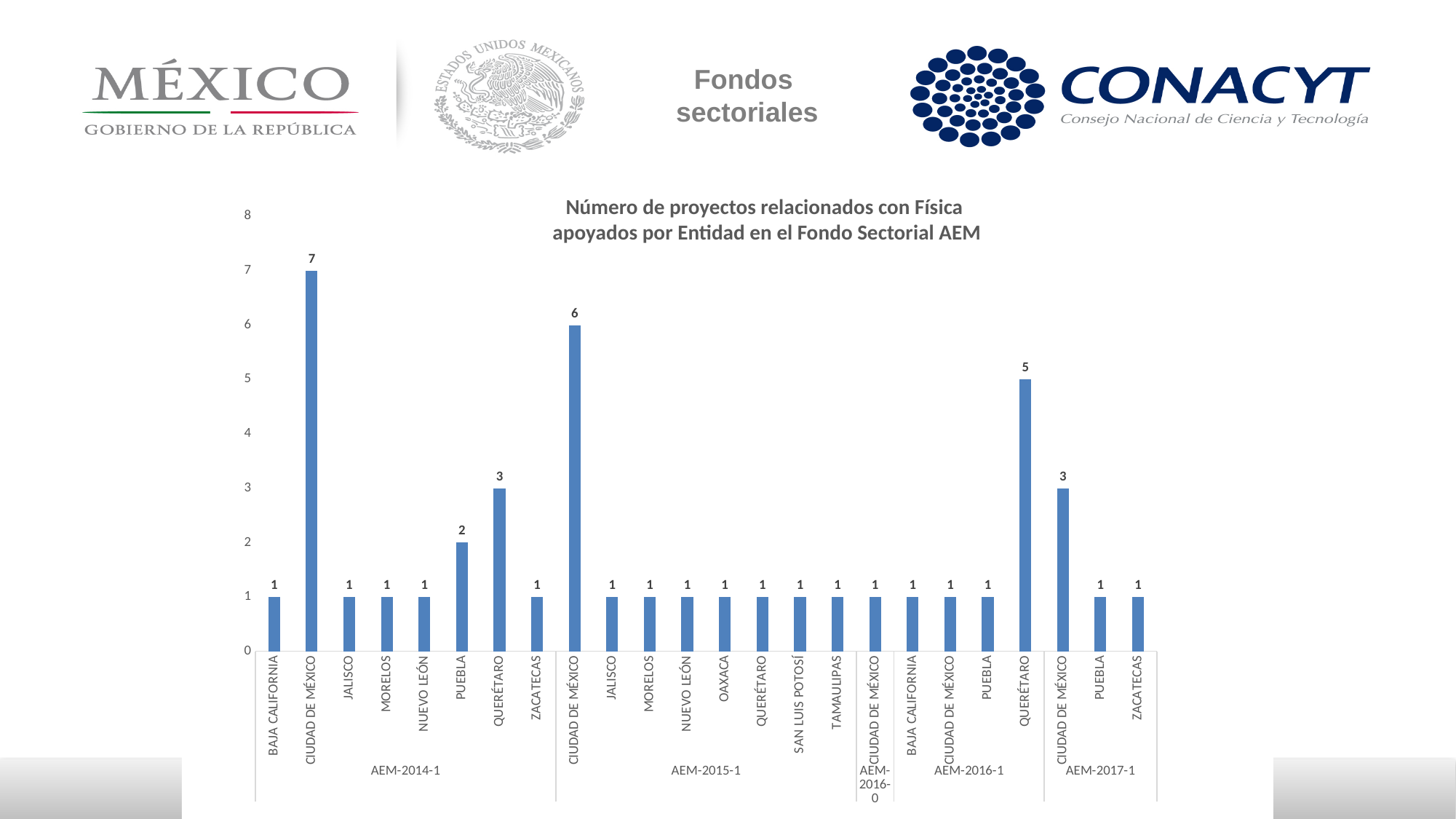
What type of chart is shown on the slide? Bar chart What is the value for Querétaro in the AEM-2016-1 group? 5 Which bar has the highest value in the whole chart? Ciudad de México (AEM-2014-1) How many projects does Ciudad de México have in the AEM-2014-1 group? 7 Which entity has the highest value in the AEM-2015-1 group? Ciudad de México What is the title of the chart? Número de proyectos relacionados con Física apoyados por Entidad en el Fondo Sectorial AEM What is the value for Ciudad de México in the AEM-2017-1 group? 3 Which is larger: Querétaro in AEM-2014-1 or Querétaro in AEM-2016-1? Querétaro in AEM-2016-1 What is the difference between Ciudad de México in AEM-2014-1 and Ciudad de México in AEM-2015-1? 1 How many bars are plotted in the chart? 24 How many fund groups (AEM calls) are shown along the x axis? 5 What is the value for Puebla in the AEM-2014-1 group? 2